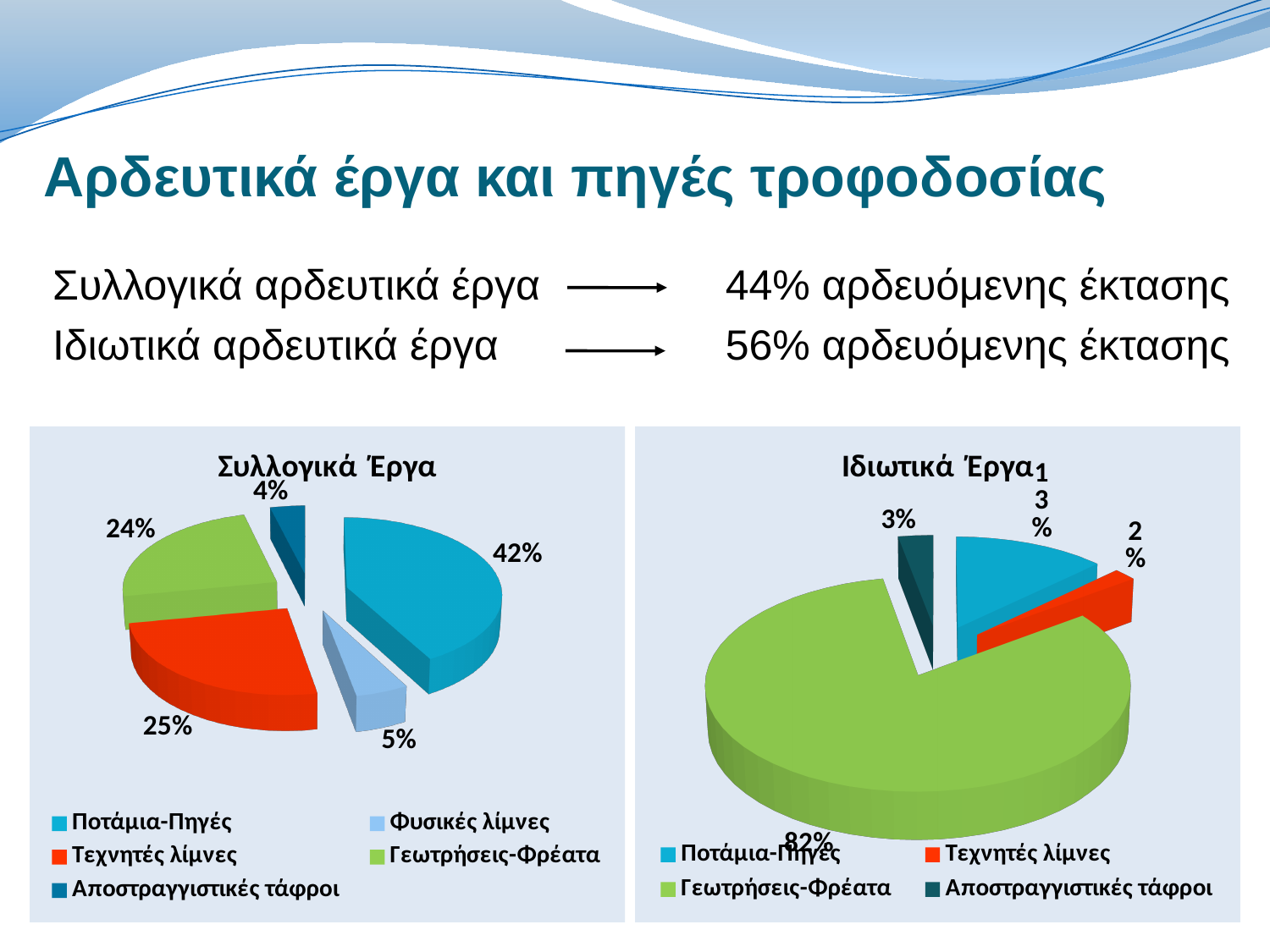
In the 'Ιδιωτικά Έργα' chart, what is the share for Αποστραγγιστικές τάφροι? 3% In the 'Συλλογικά Έργα' chart, what is the share for Ποτάμια-Πηγές? 42% In the 'Συλλογικά Έργα' chart, what is the difference between the shares of Ποτάμια-Πηγές and Φυσικές λίμνες? 37% What type of chart is the 'Συλλογικά Έργα' chart? pie chart In the 'Συλλογικά Έργα' chart, what is the share for Τεχνητές λίμνες? 25% In the 'Ιδιωτικά Έργα' chart, what is the share for Γεωτρήσεις-Φρέατα? 82% In the 'Συλλογικά Έργα' chart, which category has the largest share? Ποτάμια-Πηγές In the 'Συλλογικά Έργα' chart, which category has the smallest share? Αποστραγγιστικές τάφροι In the 'Ιδιωτικά Έργα' chart, which category has the largest share? Γεωτρήσεις-Φρέατα How many categories does the legend of the 'Ιδιωτικά Έργα' chart list? 4 In the 'Συλλογικά Έργα' chart, what is the share for Γεωτρήσεις-Φρέατα? 24% How many categories does the legend of the 'Συλλογικά Έργα' chart list? 5